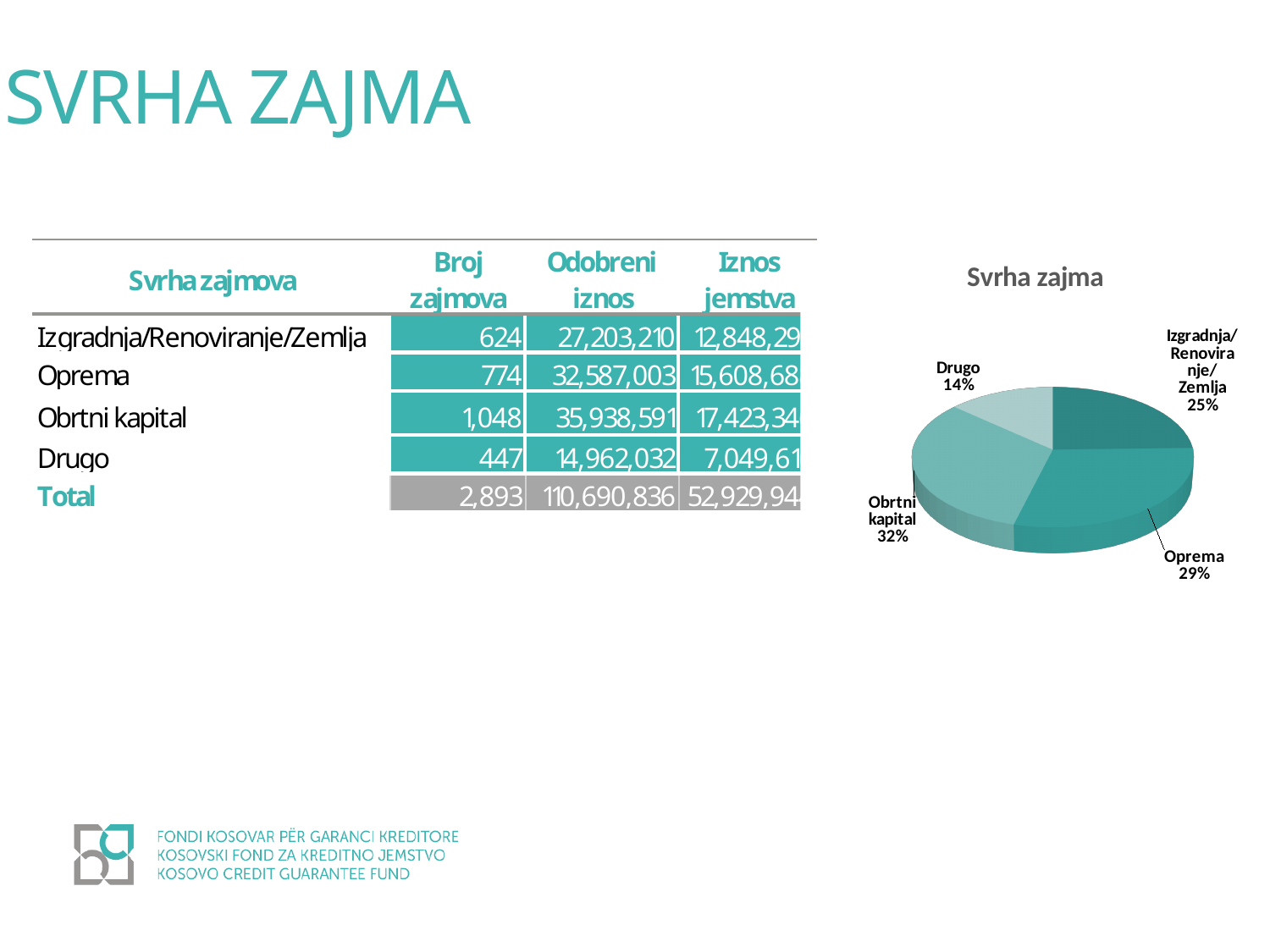
Which category has the largest slice in the pie chart? Obrtni kapital What share of the pie does Izgradnja/Renoviranje/Zemlja represent? 25% How many slices does the pie chart have? 4 Is the share for Drugo greater or less than 20%? less What is the title of the pie chart? Svrha zajma What share of the pie does Drugo represent? 14% Which category has the smallest slice in the pie chart? Drugo What type of chart is shown on the slide? Pie chart Which slice is larger, Oprema or Izgradnja/Renoviranje/Zemlja? Oprema What share of the pie does Oprema represent? 29% What is the difference in percentage points between the Obrtni kapital slice and the Drugo slice? 18